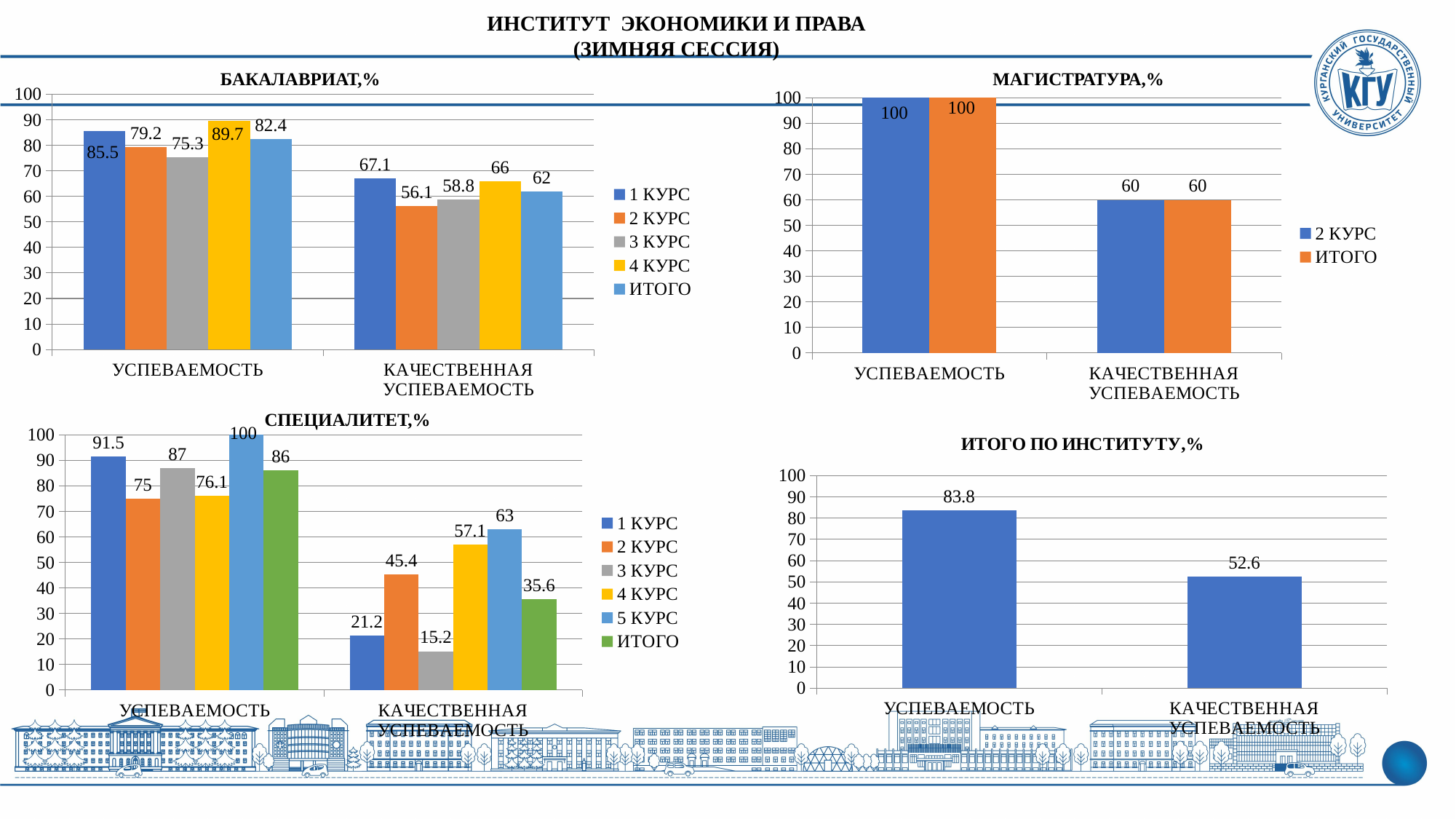
In the МАГИСТРАТУРА,% chart, what is the value for 2 КУРС in the КАЧЕСТВЕННАЯ УСПЕВАЕМОСТЬ category? 60 In the СПЕЦИАЛИТЕТ,% chart, which is larger in the КАЧЕСТВЕННАЯ УСПЕВАЕМОСТЬ category: 2 КУРС or 4 КУРС? 4 КУРС What kind of chart is the ИТОГО ПО ИНСТИТУТУ,% chart? Bar chart How many series does the legend of the БАКАЛАВРИАТ,% chart list? 5 In the БАКАЛАВРИАТ,% chart, which series has the lowest value in the КАЧЕСТВЕННАЯ УСПЕВАЕМОСТЬ category? 2 КУРС In the ИТОГО ПО ИНСТИТУТУ,% chart, what is the value for КАЧЕСТВЕННАЯ УСПЕВАЕМОСТЬ? 52.6 How many series does the legend of the СПЕЦИАЛИТЕТ,% chart list? 6 In the МАГИСТРАТУРА,% chart, what is the difference between the ИТОГО values for УСПЕВАЕМОСТЬ and КАЧЕСТВЕННАЯ УСПЕВАЕМОСТЬ? 40 In the БАКАЛАВРИАТ,% chart, what is the difference between the ИТОГО values for УСПЕВАЕМОСТЬ and КАЧЕСТВЕННАЯ УСПЕВАЕМОСТЬ? 20.4 In the СПЕЦИАЛИТЕТ,% chart, which series has the highest value in the УСПЕВАЕМОСТЬ category? 5 КУРС In the СПЕЦИАЛИТЕТ,% chart, what is the value for 3 КУРС in the КАЧЕСТВЕННАЯ УСПЕВАЕМОСТЬ category? 15.2 In the БАКАЛАВРИАТ,% chart, what is the value for 4 КУРС in the УСПЕВАЕМОСТЬ category? 89.7